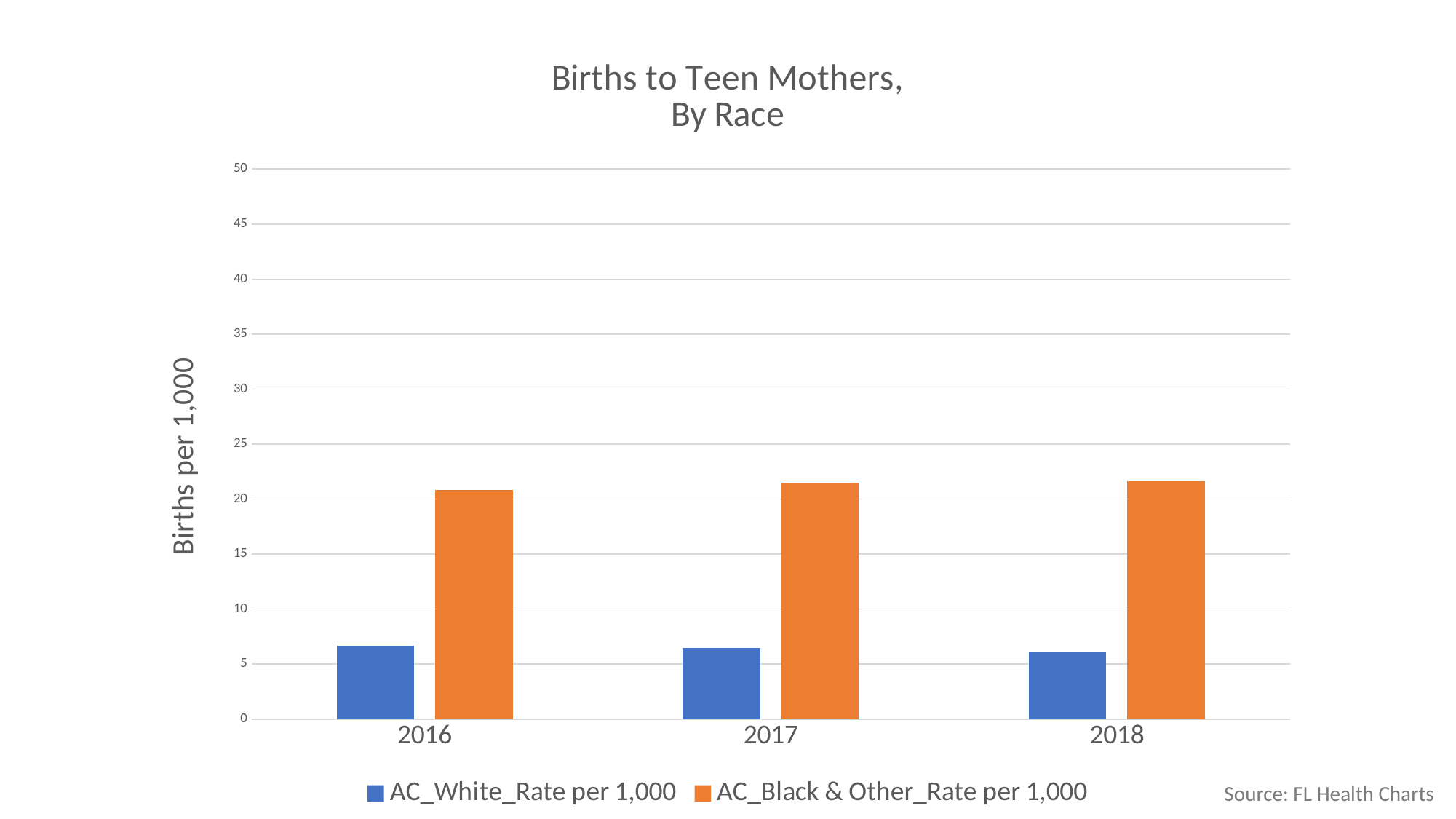
Is the AC_Black & Other_Rate per 1,000 value for 2017 greater or less than 20? greater Is the AC_White_Rate per 1,000 value for 2016 greater or less than 5? greater Is the AC_White_Rate per 1,000 value for 2018 greater or less than 10? less What is the label on the vertical axis of the chart? Births per 1,000 In 2017, which series has the larger value, AC_White_Rate per 1,000 or AC_Black & Other_Rate per 1,000? AC_Black & Other_Rate per 1,000 In 2016, is the AC_White_Rate per 1,000 bar taller or shorter than the AC_Black & Other_Rate per 1,000 bar? shorter What kind of chart is shown on the slide? bar chart How many years are shown on the x axis of the chart? 3 How many series does the legend list? 2 What is the title of the chart? Births to Teen Mothers, By Race